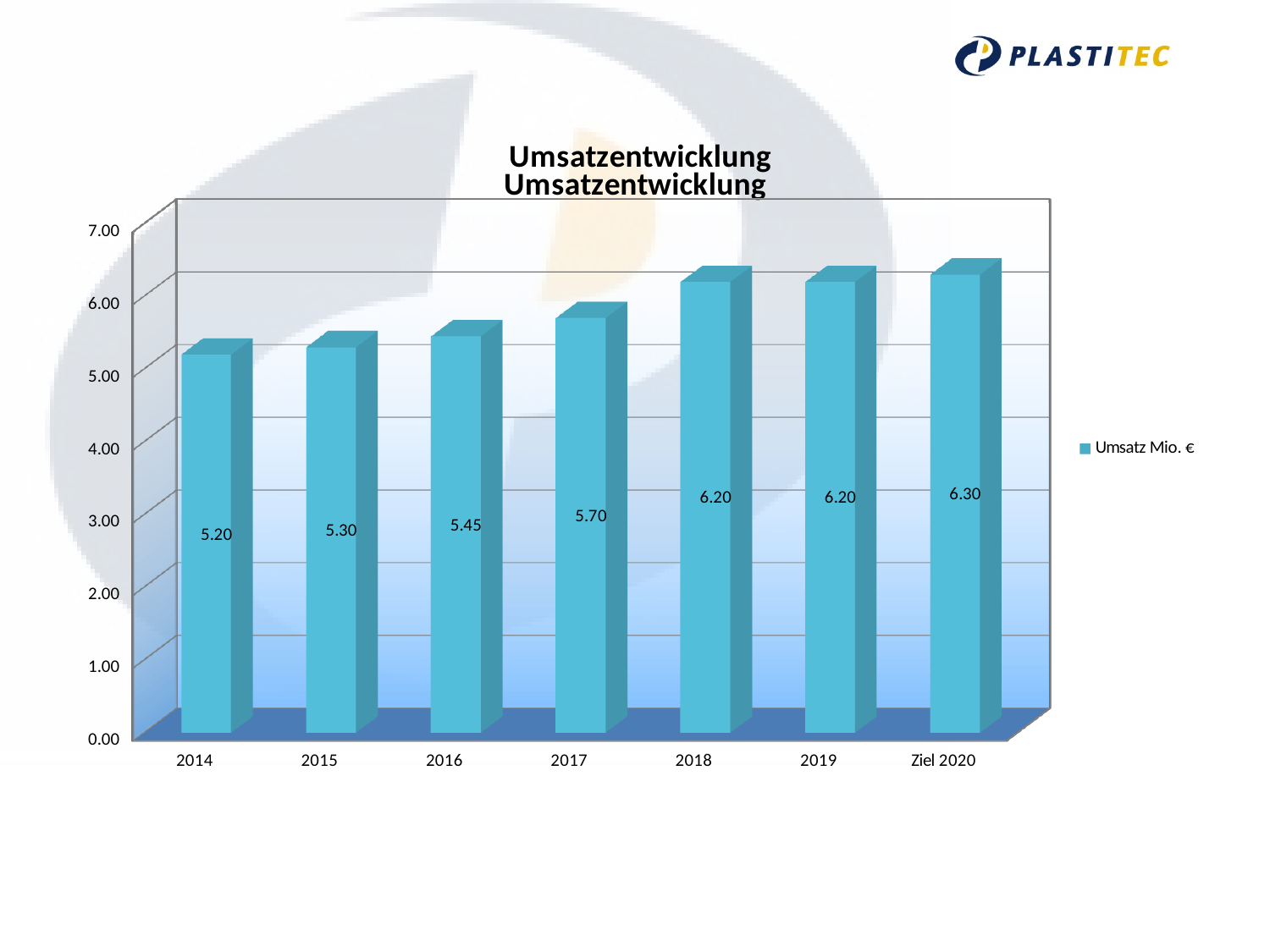
Which category has the highest value? Ziel 2020 How many categories are shown on the x axis? 7 How many series does the legend list? 1 Which is larger, the value for 2017 or the value for 2015? 2017 What is the difference between the values for 2018 and 2014? 1.00 Which category has the lowest value? 2014 What is the value for 2016? 5.45 What is the value for 2014? 5.20 What kind of chart is this? bar chart Do the values rise or fall from 2014 to Ziel 2020? rise What is the value for Ziel 2020? 6.30 Is the value for 2019 greater or less than 6.00? greater